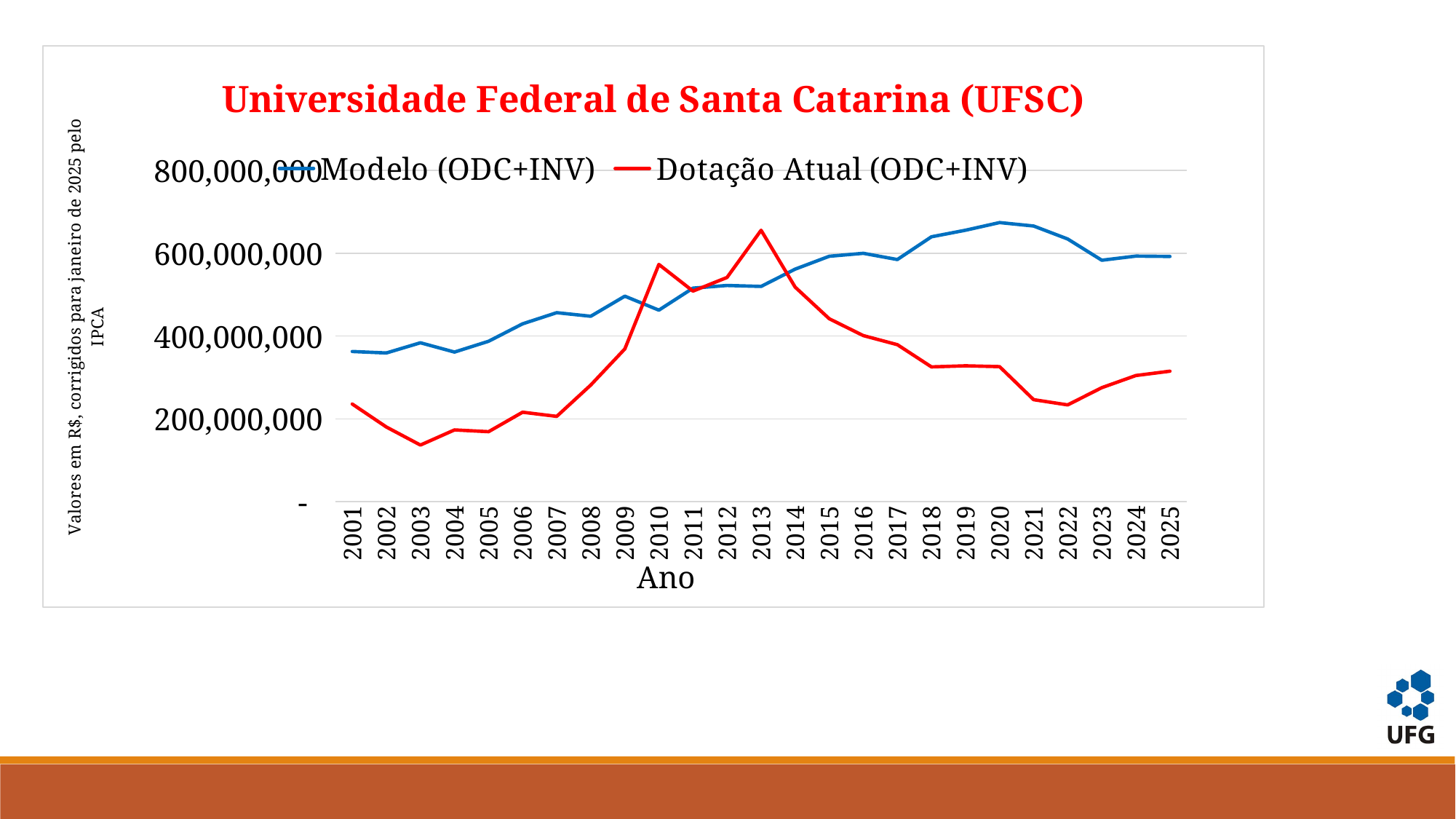
Does the Dotação Atual (ODC+INV) series rise or fall between 2013 and 2022? fall Is the value for Dotação Atual (ODC+INV) in 2003 greater or less than 200,000,000? less Which series is drawn in red? Dotação Atual (ODC+INV) In which year does the Dotação Atual (ODC+INV) series reach its lowest value? 2003 In which year does the Dotação Atual (ODC+INV) series reach its highest value? 2013 In 2020, which series has the larger value, Modelo (ODC+INV) or Dotação Atual (ODC+INV)? Modelo (ODC+INV) How many years are plotted along the x axis? 25 How many series does the legend list? 2 What kind of chart is shown on the slide? line chart Is the value for Dotação Atual (ODC+INV) in 2013 greater or less than 600,000,000? greater What is the title of the chart? Universidade Federal de Santa Catarina (UFSC) In which year does the Modelo (ODC+INV) series reach its highest value? 2020